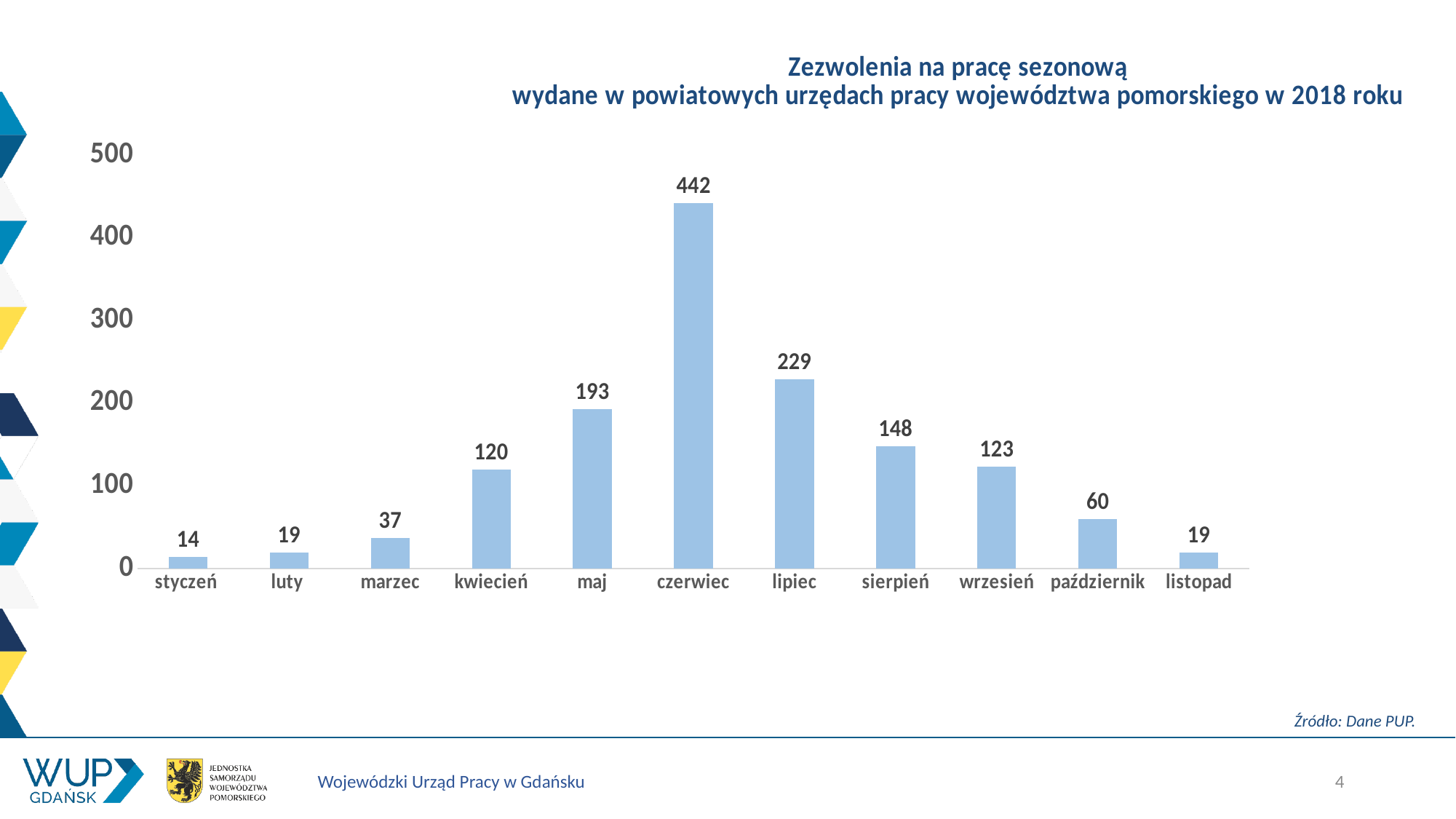
What is the difference between the values for maj and sierpień? 45 What is the source given below the chart? Dane PUP. What is the value for październik? 60 How many months are shown on the x axis? 11 Is the value for lipiec greater or less than 200? greater Which month has the highest value? czerwiec Which is larger, the value for sierpień or the value for wrzesień? sierpień What is the value for czerwiec? 442 What is the value for kwiecień? 120 What is the difference between the values for czerwiec and lipiec? 213 Which month has the lowest value? styczeń What kind of chart is shown on the slide? bar chart